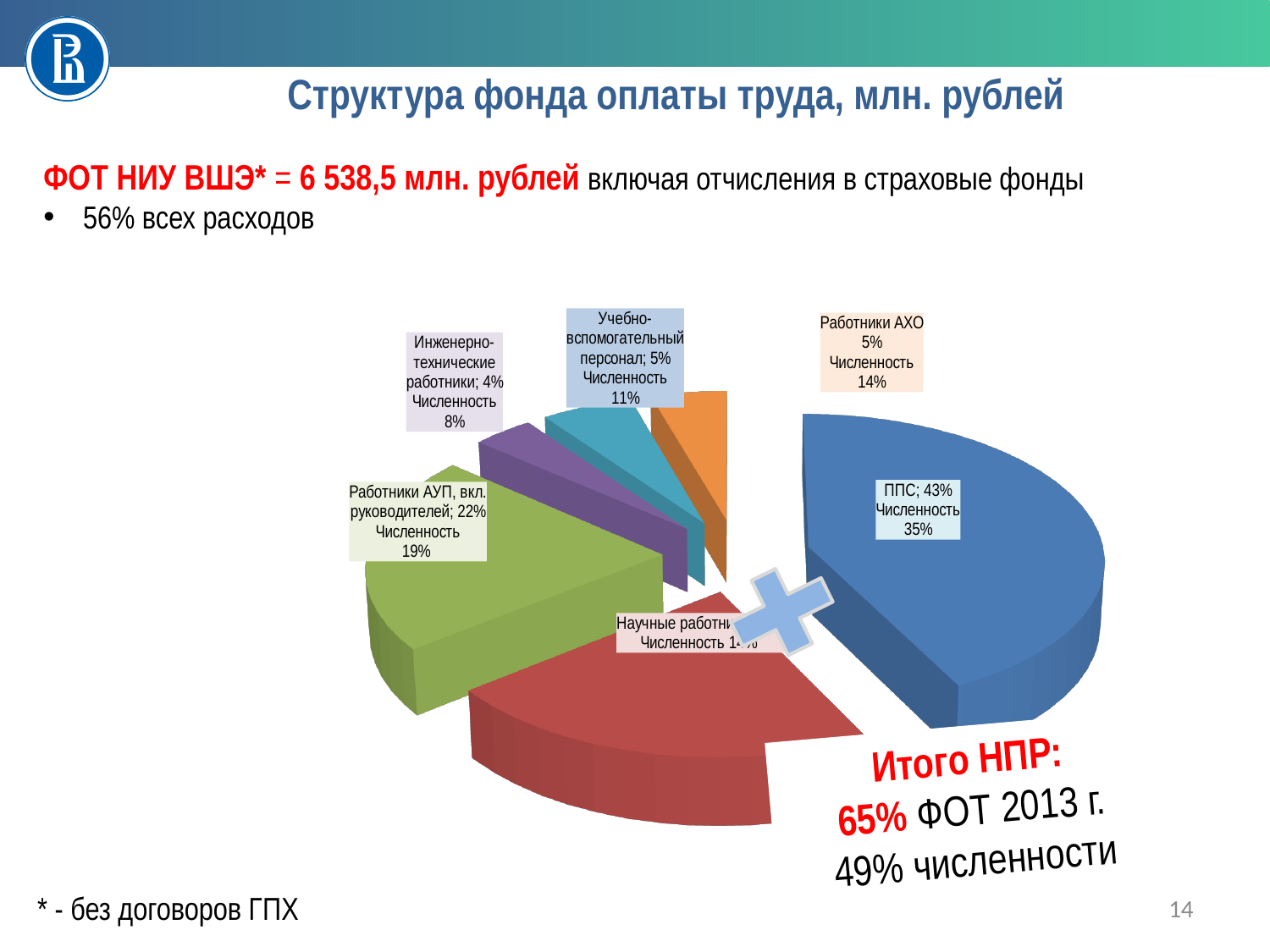
What kind of chart is shown on the slide? Pie chart What share of the pie does the slice for Работники АХО represent? 5% Which category has the smallest slice of the pie? Инженерно-технические работники What share of the pie does the slice for Работники АУП, вкл. руководителей represent? 22% What is the title of the chart on the slide? Структура фонда оплаты труда, млн. рублей What share of the pie does the slice for Учебно-вспомогательный персонал represent? 5% How many slices does the pie chart have? 6 What is the Численность value shown in the label for ППС? 35% What is the difference in percentage points between the ППС slice and the Работники АУП, вкл. руководителей slice? 21 percentage points Which category has the largest slice of the pie? ППС